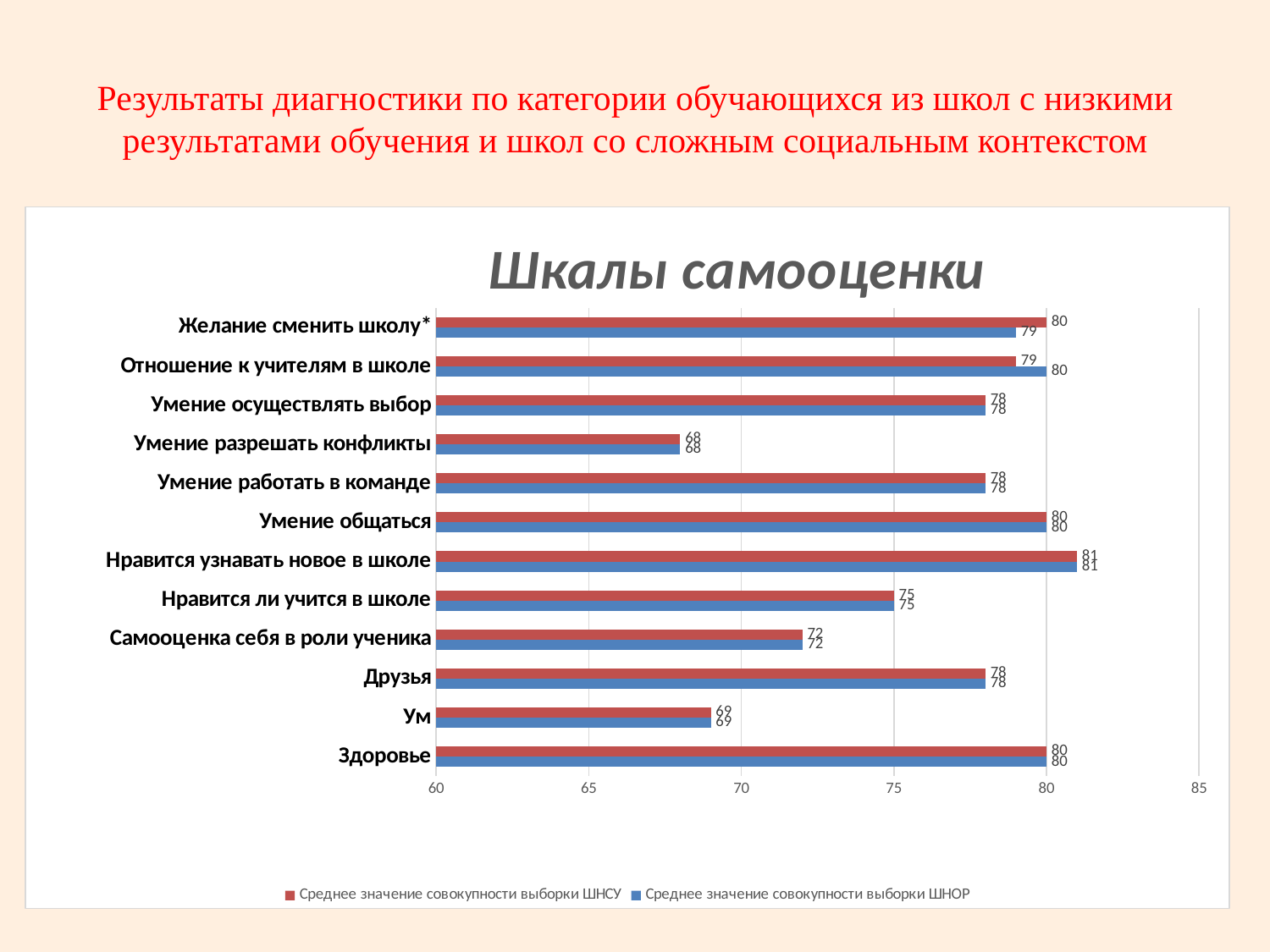
What is the value for 'Умение разрешать конфликты' in the ШНОР series? 68 How many categories are shown on the chart? 12 Which is larger in the ШНОР series: 'Нравится ли учится в школе' or 'Самооценка себя в роли ученика'? Нравится ли учится в школе What is the title of the chart? Шкалы самооценки Which category has the highest value in the ШНСУ series? Нравится узнавать новое в школе Is the ШНСУ value for 'Друзья' greater or less than 75? greater Which category has the lowest value in the ШНОР series? Умение разрешать конфликты What is the value for 'Желание сменить школу*' in the ШНСУ series? 80 What is the value for 'Отношение к учителям в школе' in the ШНОР series? 80 What type of chart is shown on the slide? Bar chart How many series does the legend list? 2 What is the difference between the ШНСУ values for 'Здоровье' and 'Ум'? 11